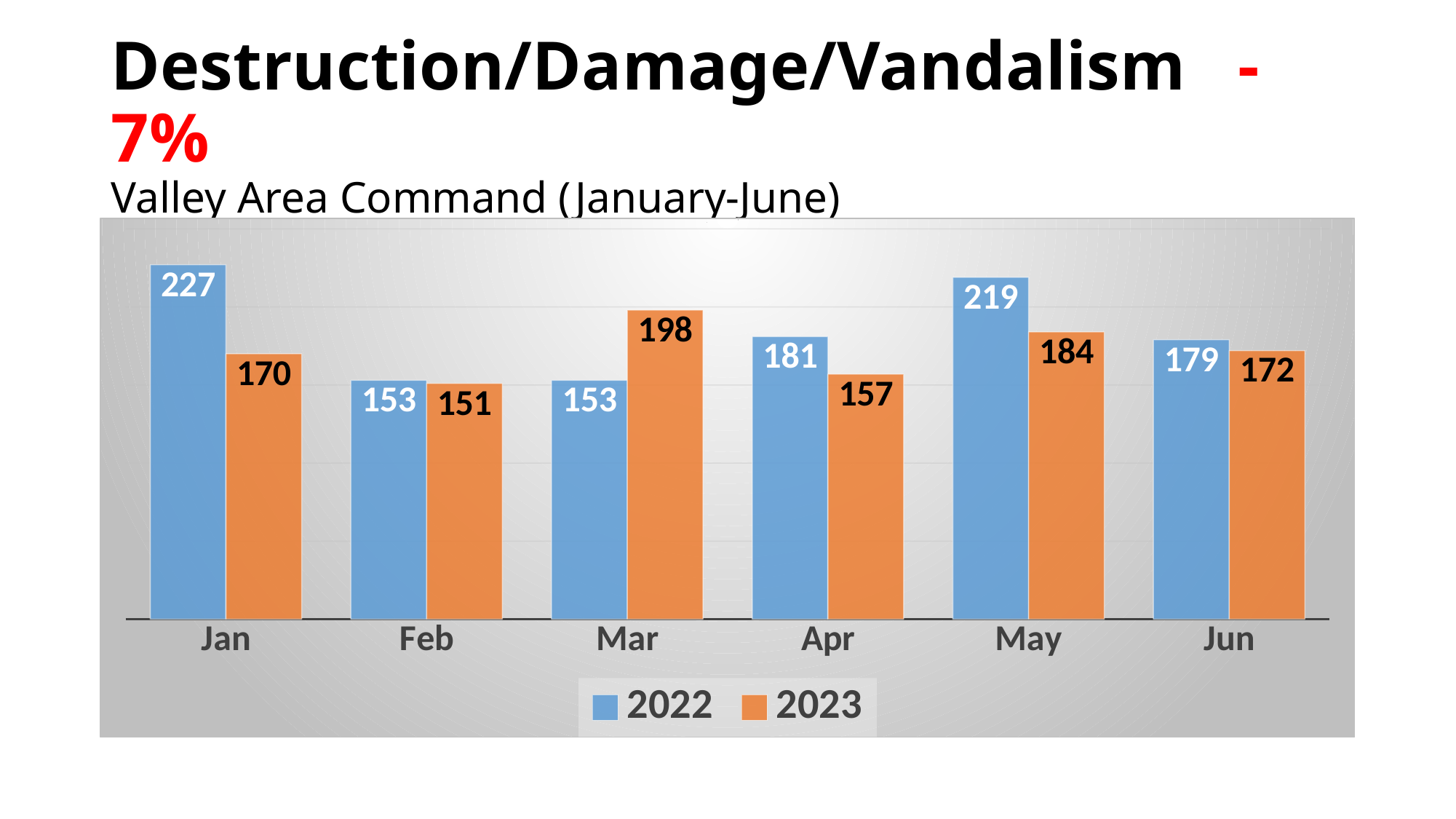
Which month has the highest value for 2022? Jan Which month has the lowest value for 2023? Feb How many series does the legend list? 2 How many months are shown on the x axis? 6 What is the difference between the 2022 and 2023 values in May? 35 What is the value for 2023 in Jun? 172 Which is larger in Mar, the 2022 value or the 2023 value? 2023 Which colour represents the 2023 series? Orange What is the value for 2022 in Jan? 227 What kind of chart is shown on the slide? Bar chart What is the value for 2023 in Mar? 198 What is the difference between the 2022 and 2023 values in Jan? 57